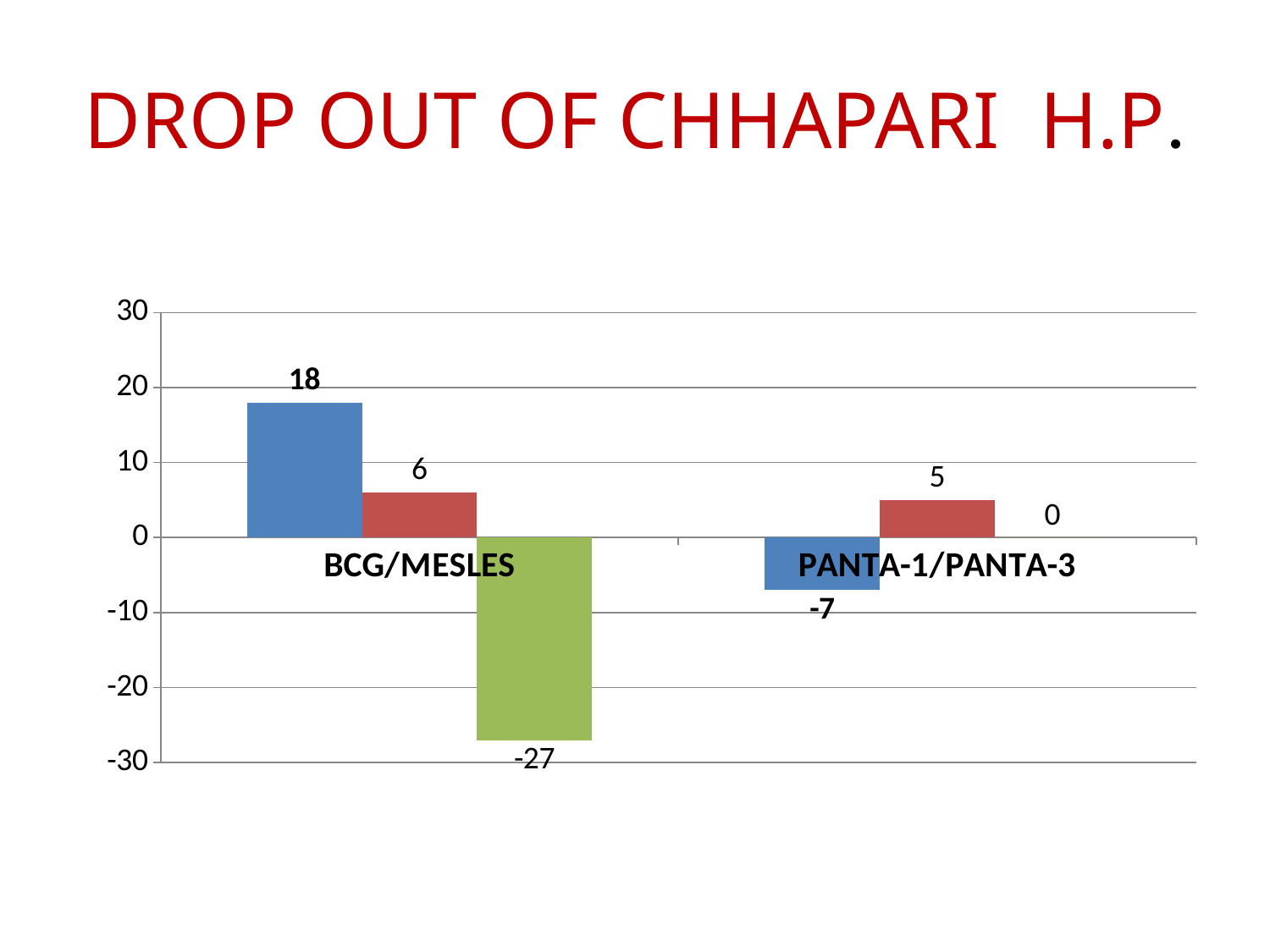
What is the difference between the blue bar and the red bar for BCG/MESLES? 12 Which bar has the highest value on the chart? The blue bar for BCG/MESLES (18) How many categories are shown on the x axis? 2 What is the value of the blue bar for PANTA-1/PANTA-3? -7 Which is larger, the red bar for BCG/MESLES or the red bar for PANTA-1/PANTA-3? The red bar for BCG/MESLES What is the title of the slide? DROP OUT OF CHHAPARI H.P. What is the value of the green bar for PANTA-1/PANTA-3? 0 What is the value of the green bar for BCG/MESLES? -27 Which bar has the lowest value on the chart? The green bar for BCG/MESLES (-27) What is the value of the blue bar for BCG/MESLES? 18 What type of chart is shown on the slide? Bar chart What is the value of the red bar for PANTA-1/PANTA-3? 5